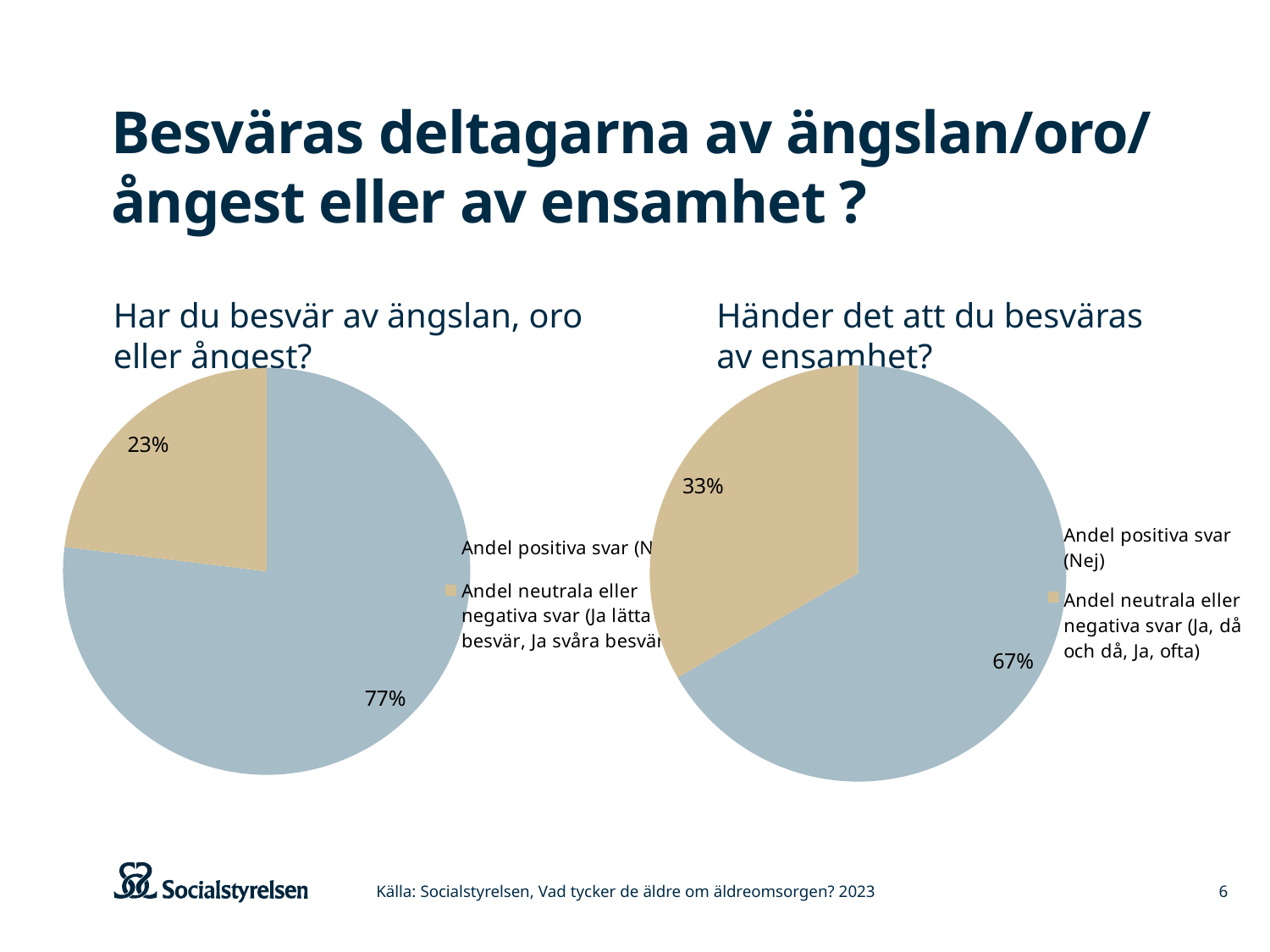
How many entries does the legend of the left chart "Har du besvär av ängslan, oro eller ångest?" list? 2 In the right chart "Händer det att du besväras av ensamhet?", which slice is the smallest? Andel neutrala eller negativa svar (Ja, då och då, Ja, ofta) In the left chart "Har du besvär av ängslan, oro eller ångest?", what share is labelled for the positive answers (Nej)? 77% How many slices does the right chart "Händer det att du besväras av ensamhet?" have? 2 In the left chart "Har du besvär av ängslan, oro eller ångest?", which slice is the largest? Andel positiva svar (Nej) In the right chart "Händer det att du besväras av ensamhet?", what is the difference in percentage points between the positive and the neutral/negative slices? 34 percentage points What kind of chart is used for "Har du besvär av ängslan, oro eller ångest?"? Pie chart In the left chart "Har du besvär av ängslan, oro eller ångest?", what share is labelled for the neutral or negative answers? 23% In the left chart "Har du besvär av ängslan, oro eller ångest?", what is the difference in percentage points between the positive and the neutral/negative slices? 54 percentage points Which chart has the larger share of neutral or negative answers, the left chart about ängslan/oro/ångest or the right chart about ensamhet? The right chart about ensamhet In the right chart "Händer det att du besväras av ensamhet?", what share is labelled for the neutral or negative answers? 33% In the right chart "Händer det att du besväras av ensamhet?", what share is labelled for the positive answers (Nej)? 67%